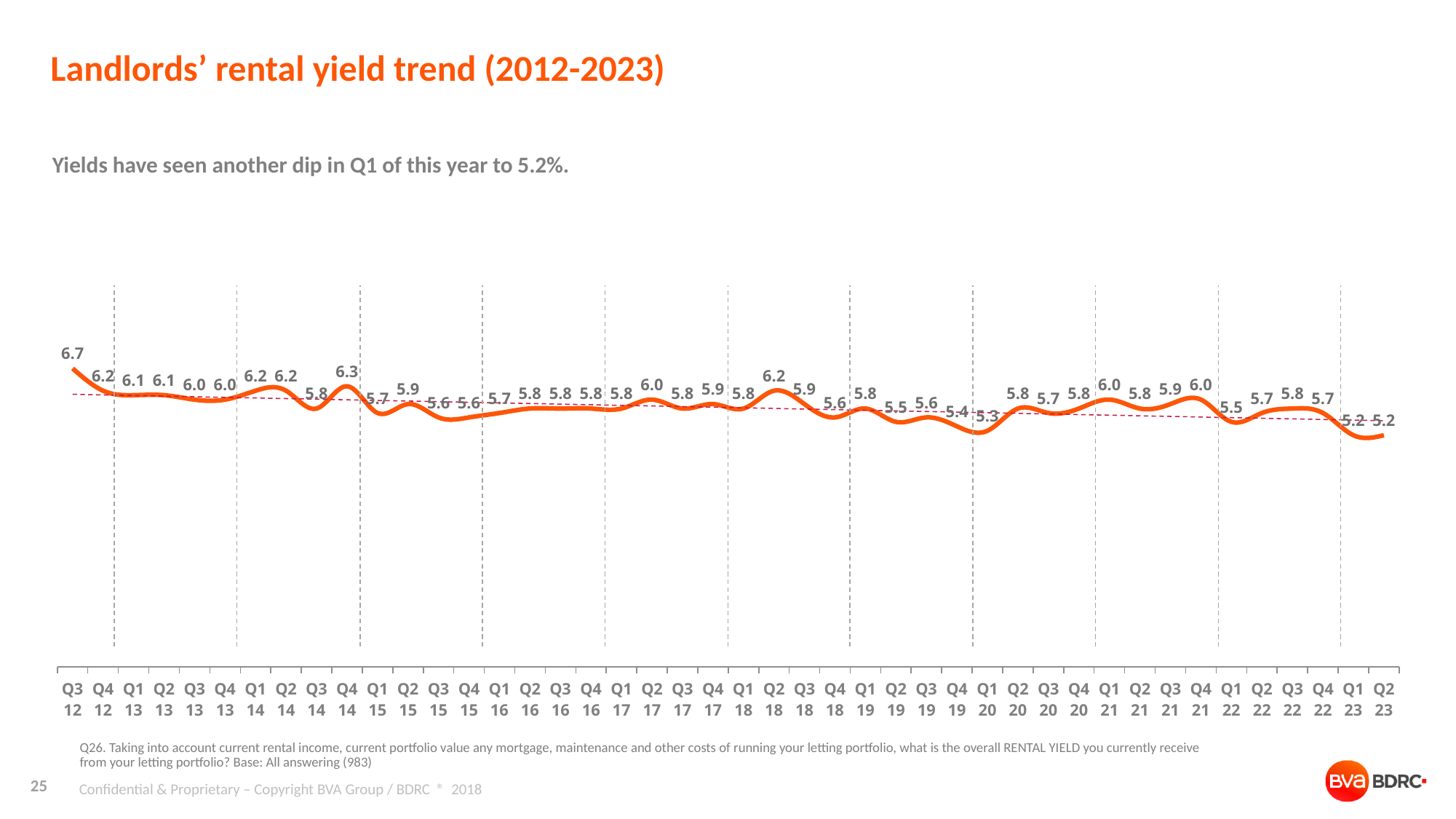
What is the lowest rental yield value shown on the chart? 5.2 What is the rental yield value for Q2 18? 6.2 What is the rental yield value for Q4 14? 6.3 What kind of chart is shown on the slide? Line chart Overall, do the rental yield values rise or fall from Q3 12 to Q2 23? Fall Which is larger, the rental yield for Q4 14 or for Q1 15? Q4 14 What is the rental yield value for Q3 12? 6.7 How many quarterly data points are plotted on the chart? 44 What is the difference between the rental yield for Q3 12 and Q2 23? 1.5 What is the title of the chart on the slide? Landlords' rental yield trend (2012-2023) Which quarter has the highest rental yield value? Q3 12 What is the rental yield value for Q1 20? 5.3